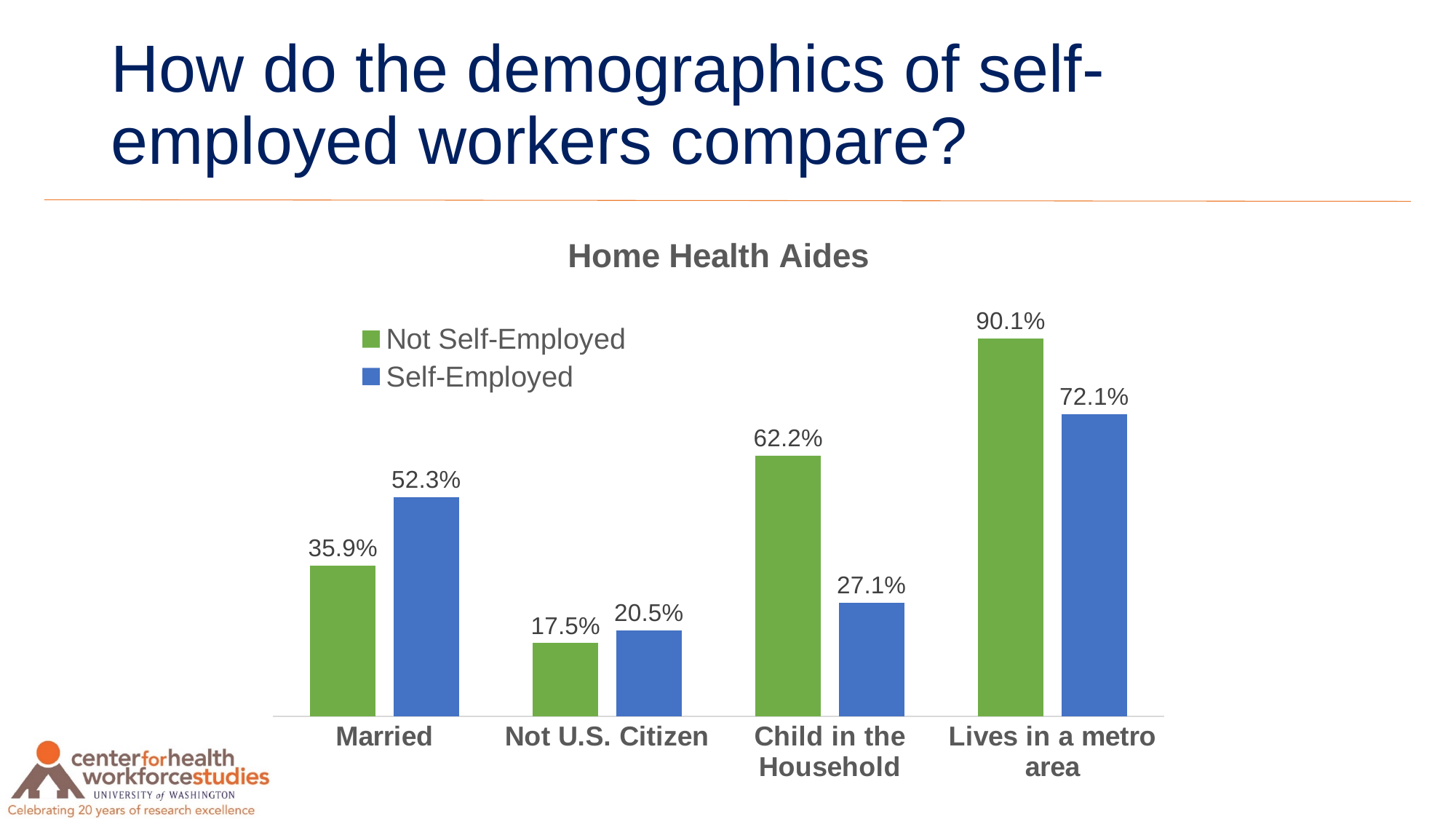
What kind of chart is shown on the slide? Bar chart What is the title of the chart? Home Health Aides How many categories are shown on the x axis? 4 In the Not U.S. Citizen category, which is larger: Not Self-Employed or Self-Employed? Self-Employed What is the difference between the Not Self-Employed and Self-Employed values in the Child in the Household category? 35.1% Which category has the highest value for Not Self-Employed? Lives in a metro area What is the value for Self-Employed in the Child in the Household category? 27.1% Which category has the lowest value for Self-Employed? Not U.S. Citizen What is the value for Not Self-Employed in the Married category? 35.9% What is the value for Self-Employed in the Lives in a metro area category? 72.1% How many series does the legend list? 2 What is the difference between the Self-Employed and Not Self-Employed values in the Married category? 16.4%